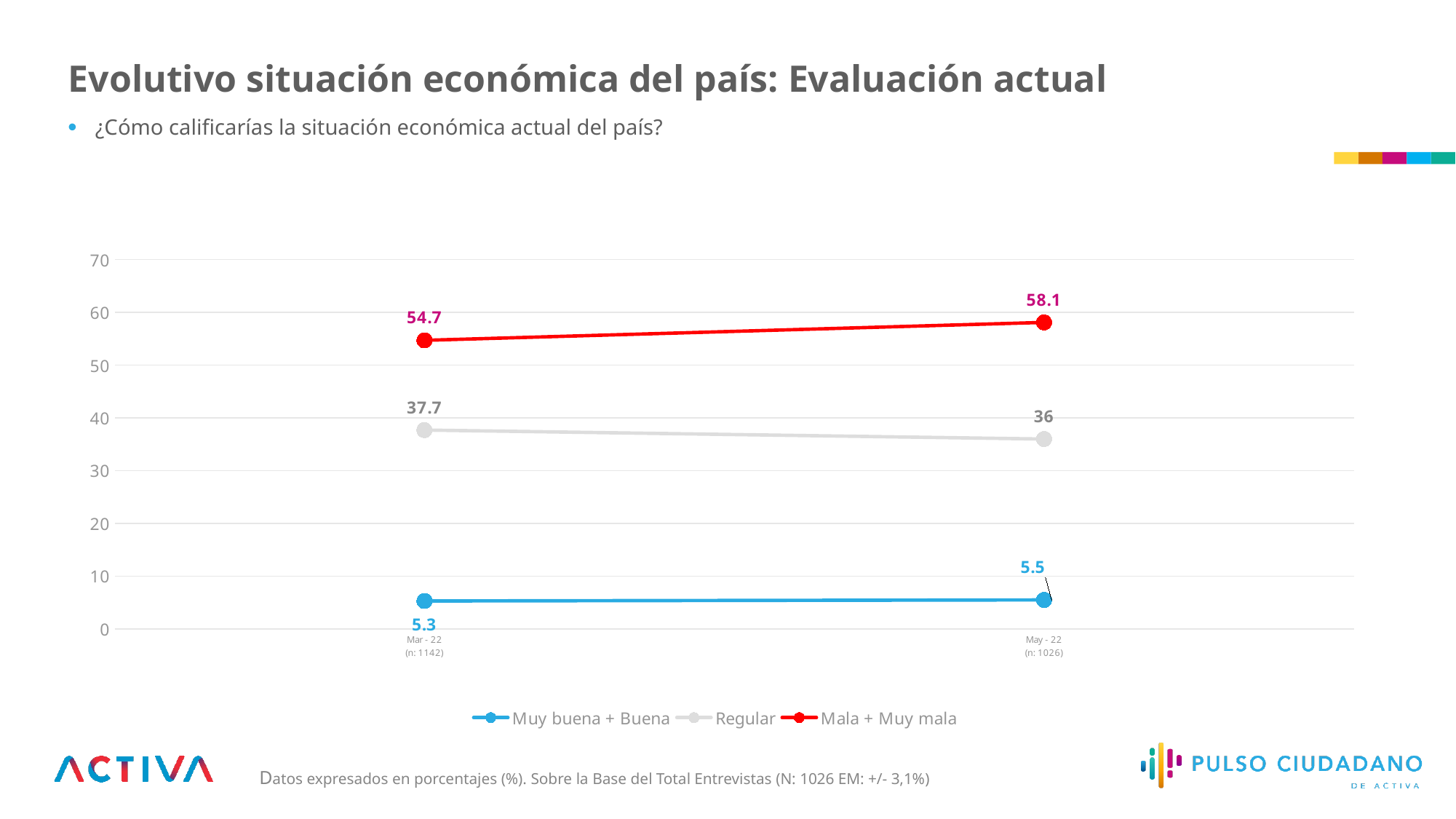
By how much did Mala + Muy mala change from Mar - 22 to May - 22? 3.4 How many series does the legend list? 3 Which series has the lowest value in Mar - 22? Muy buena + Buena What is the value for Mala + Muy mala in May - 22? 58.1 Which is larger: Regular in Mar - 22 or Regular in May - 22? Regular in Mar - 22 What is the value for Regular in May - 22? 36 What is the value for Muy buena + Buena in Mar - 22? 5.3 What kind of chart is shown on the slide? line chart Does the Regular series rise or fall from Mar - 22 to May - 22? fall How many time points are plotted on the x axis? 2 What is the value for Regular in Mar - 22? 37.7 Which series has the highest value in May - 22? Mala + Muy mala